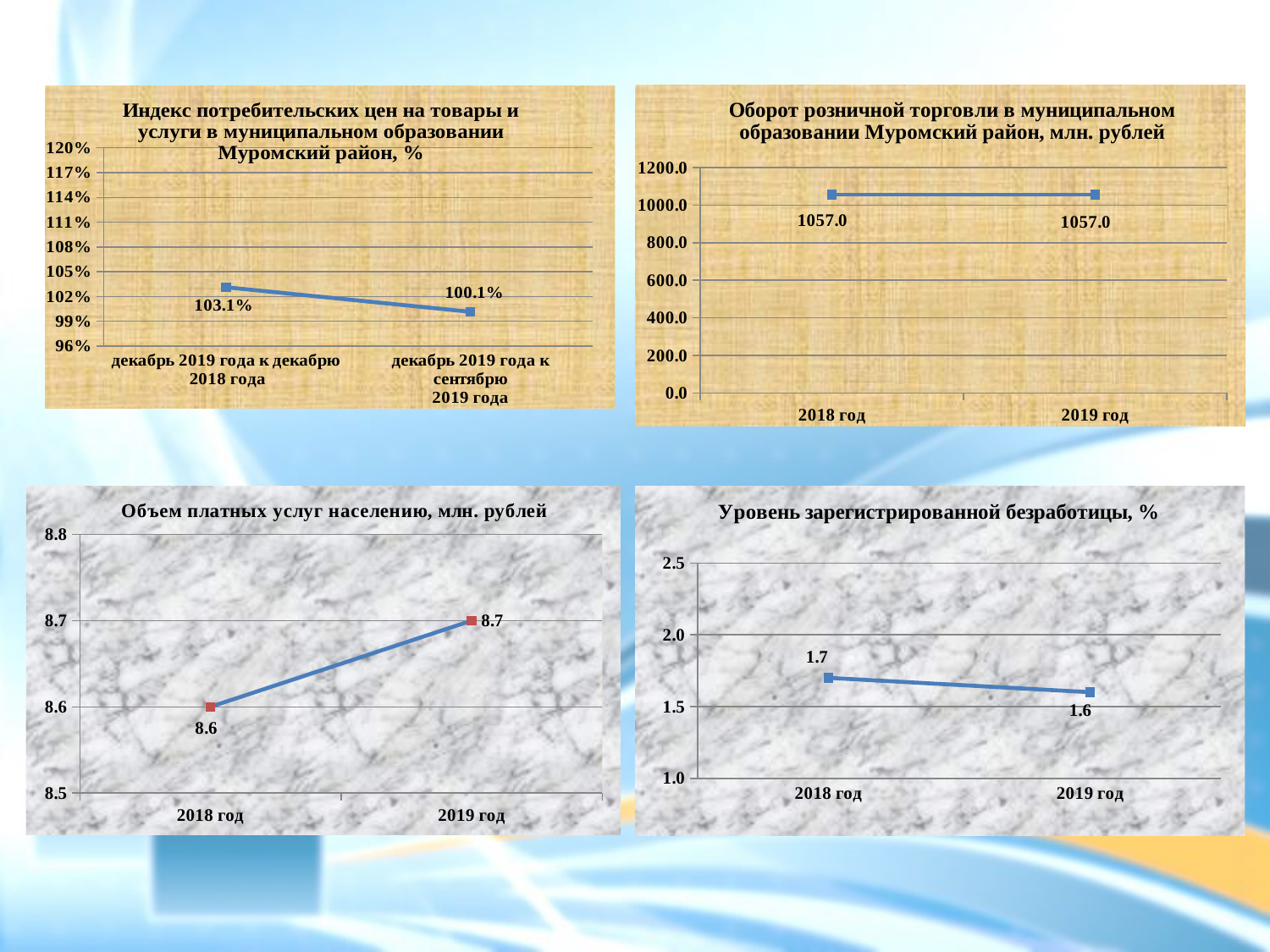
In the top-right chart (Оборот розничной торговли), what is the value for 2018 год? 1057.0 What kind of chart is the bottom-right chart (Уровень зарегистрированной безработицы)? line chart In the bottom-right chart (Уровень зарегистрированной безработицы), what is the difference between the 2018 год and 2019 год values? 0.1 In the bottom-left chart (Объем платных услуг населению), which year has the lower value? 2018 год In the top-right chart (Оборот розничной торговли), do the values rise, fall or stay the same from 2018 год to 2019 год? stay the same In the bottom-left chart (Объем платных услуг населению), what is the value for 2019 год? 8.7 In the top-right chart (Оборот розничной торговли), is the value for 2019 год greater or less than 1000.0? greater In the top-left chart (Индекс потребительских цен), what is the value for декабрь 2019 года к декабрю 2018 года? 103.1% In the top-left chart (Индекс потребительских цен), what is the difference between the two plotted values? 3.0% In the bottom-right chart (Уровень зарегистрированной безработицы), what is the value for 2018 год? 1.7 In the bottom-left chart (Объем платных услуг населению), do the values rise or fall from 2018 год to 2019 год? rise In the top-left chart (Индекс потребительских цен), what is the value for декабрь 2019 года к сентябрю 2019 года? 100.1%